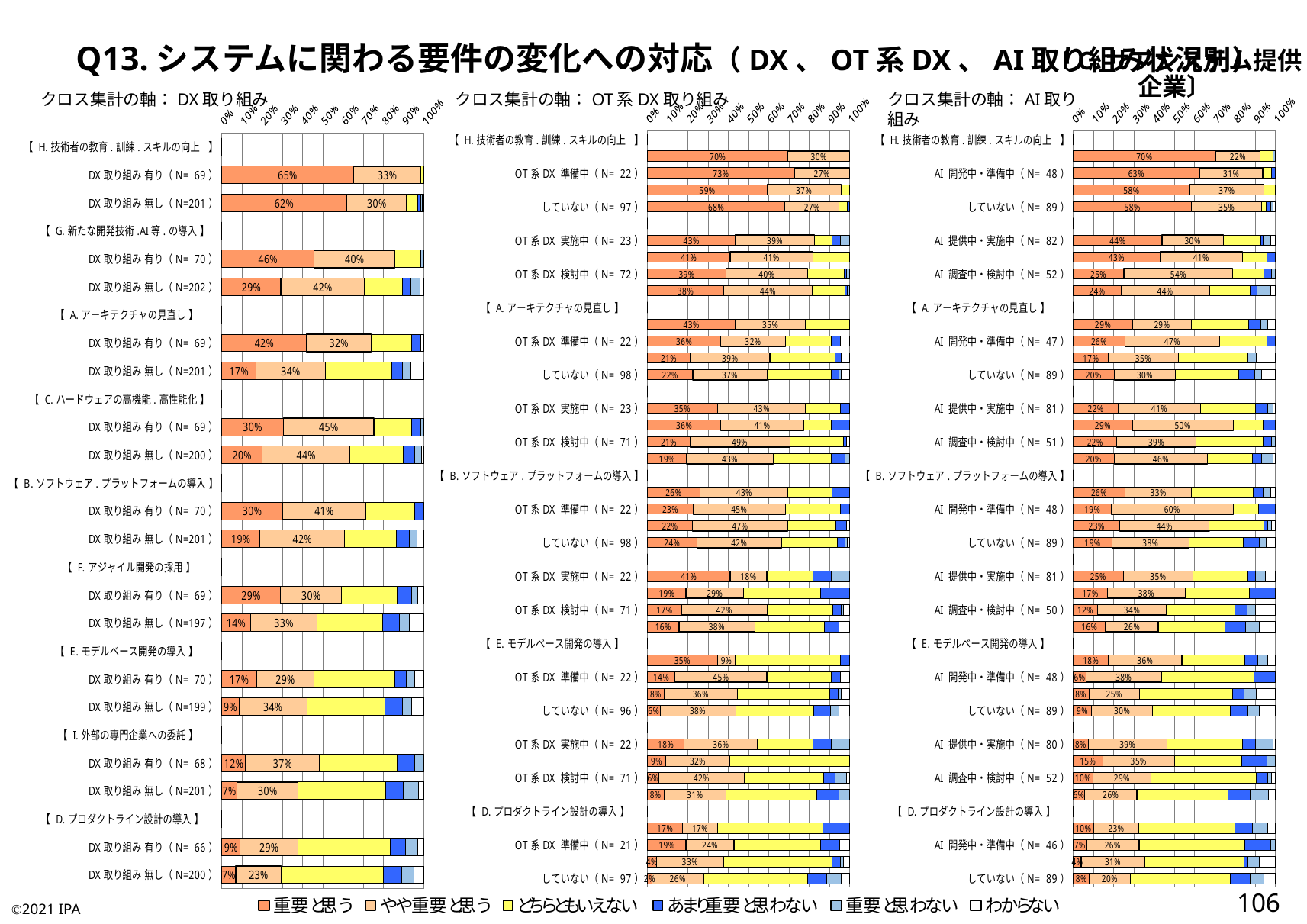
What type of chart is used for the three charts on this slide? Stacked bar chart In the middle chart (クロス集計の軸：OT系DX取り組み), what percentage of OT系DX準備中 (N=22) respondents answered 重要と思う for H. 技術者の教育.訓練.スキルの向上? 73% In the middle chart (クロス集計の軸：OT系DX取り組み), what percentage of していない (N=97) respondents answered やや重要と思う for H. 技術者の教育.訓練.スキルの向上? 27% In the left chart (クロス集計の軸：DX取り組み), for C. ハードウェアの高機能.高性能化 among DX取り組み有り (N=69), what is the difference between the やや重要と思う share (45%) and the 重要と思う share (30%)? 15 percentage points In the left chart (クロス集計の軸：DX取り組み), for A. アーキテクチャの見直し, which group has the larger 重要と思う share: DX取り組み有り or DX取り組み無し? DX取り組み有り In the left chart (クロス集計の軸：DX取り組み), which row has the highest 重要と思う share? DX取り組み有り (N=69) for H. 技術者の教育.訓練.スキルの向上, 65% In the left chart (クロス集計の軸：DX取り組み), for H. 技術者の教育.訓練.スキルの向上, how many percentage points higher is the 重要と思う share for DX取り組み有り (65%) than for DX取り組み無し (62%)? 3 percentage points In the right chart (クロス集計の軸：AI取り組み), what percentage of AI開発中・準備中 (N=48) respondents answered 重要と思う for H. 技術者の教育.訓練.スキルの向上? 63% How many response categories does the legend at the bottom of the slide list? 6 In the left chart (クロス集計の軸：DX取り組み), what percentage of DX取り組み有り (N=69) respondents answered 重要と思う for H. 技術者の教育.訓練.スキルの向上? 65% In the right chart (クロス集計の軸：AI取り組み), what percentage of AI調査中・検討中 (N=52) respondents answered やや重要と思う for G. 新たな開発技術.AI等.の導入? 54% In the left chart (クロス集計の軸：DX取り組み), what percentage of DX取り組み無し (N=202) respondents answered やや重要と思う for G. 新たな開発技術.AI等.の導入? 42%